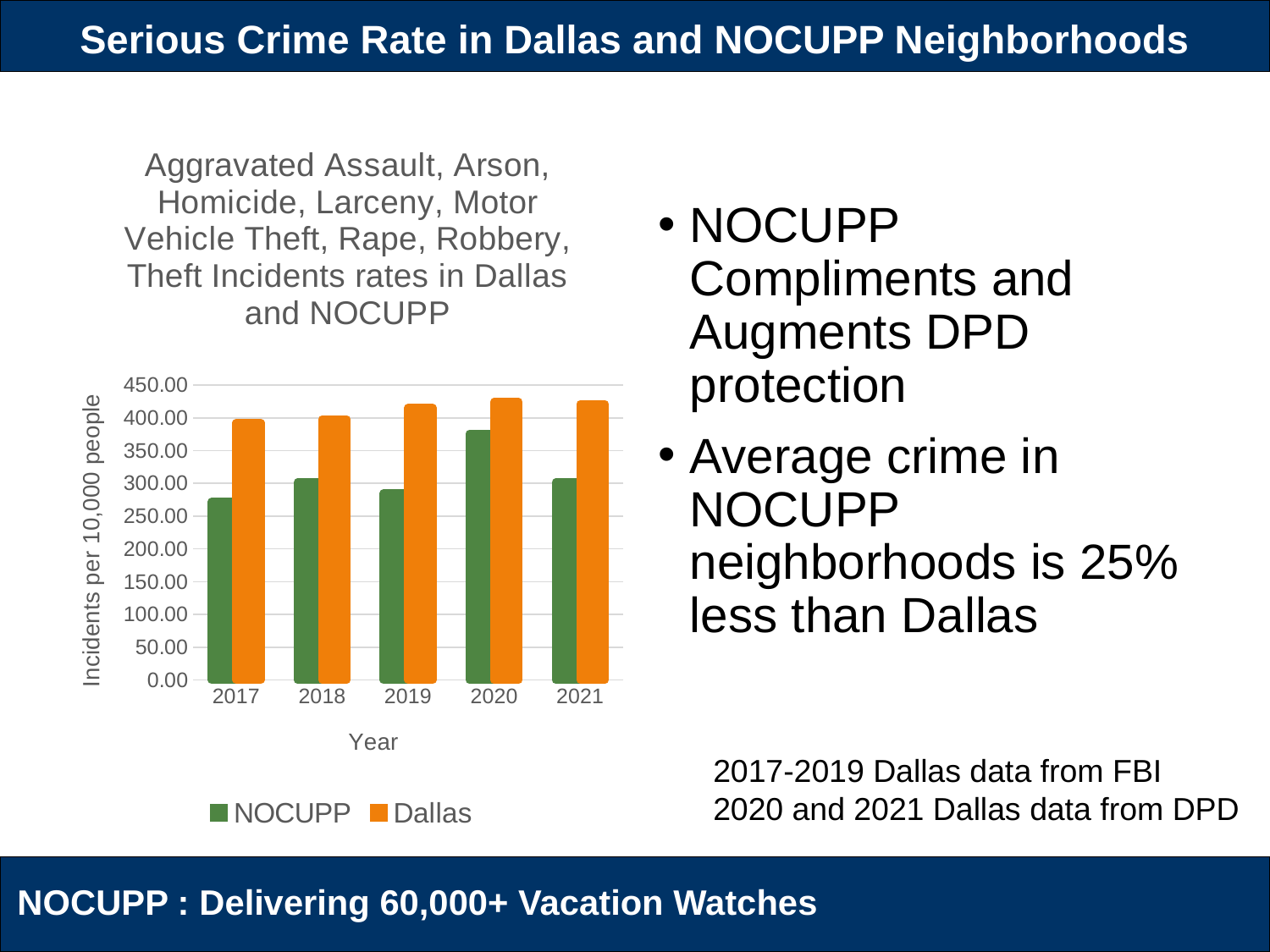
Which colour represents the Dallas series in the chart? orange How many years are shown on the x axis of the chart? 5 Is the Dallas value for 2021 greater or less than 400.00? greater Which year has the highest NOCUPP value in the chart? 2020 In 2020, which is larger, the NOCUPP value or the Dallas value? Dallas What is the label of the y axis of the chart? Incidents per 10,000 people What kind of chart is shown on the slide? bar chart Which year has the lowest NOCUPP value in the chart? 2017 How many series does the chart legend list? 2 Is the NOCUPP value for 2017 greater or less than 300.00? less Is the Dallas value for 2019 greater or less than 400.00? greater